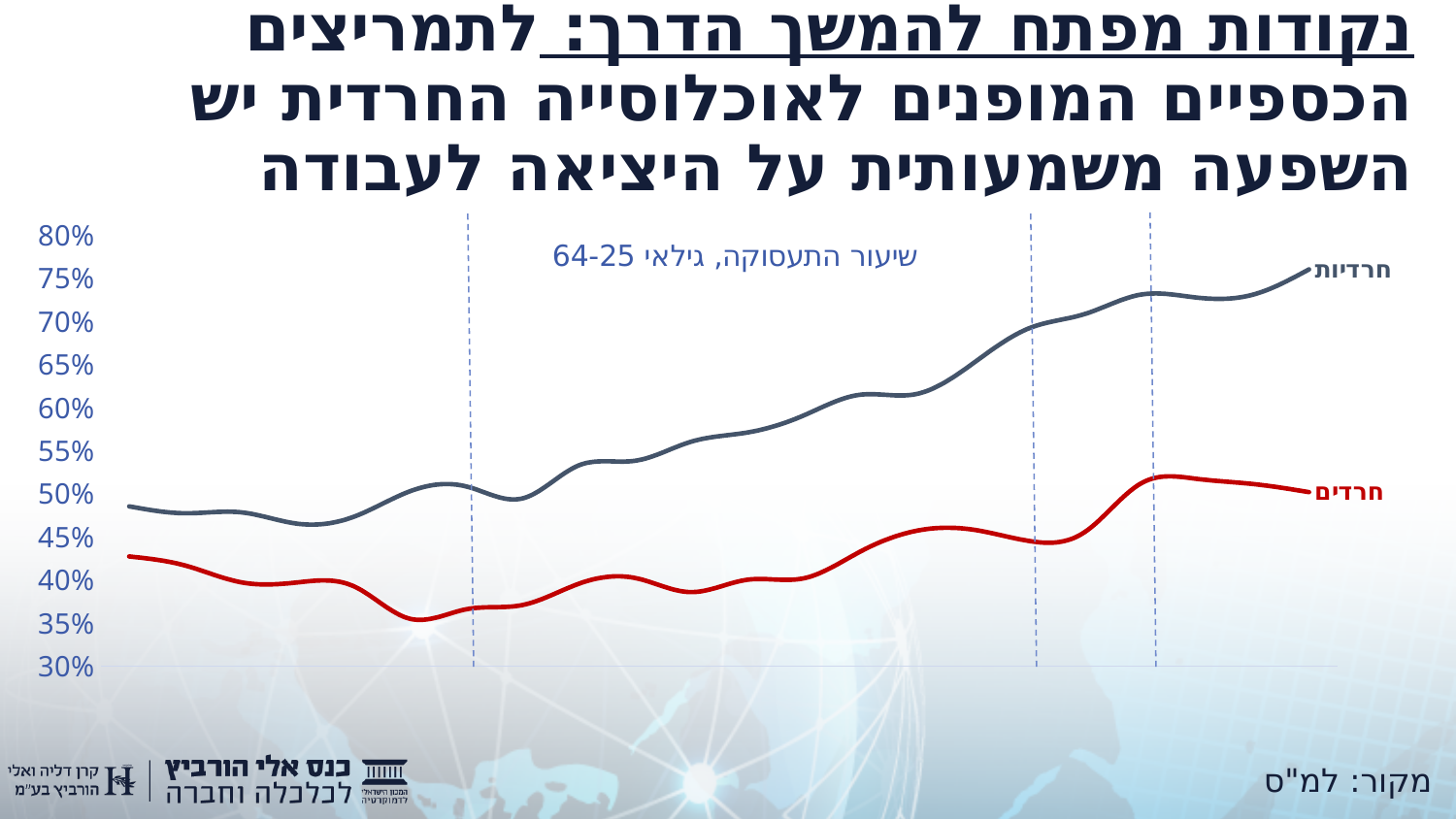
Is the value for חרדים at the left end of the chart greater or less than 40%? greater How many series does the chart show? 2 What kind of chart is shown on the slide? line chart What is the title of the chart? שיעור התעסוקה, גילאי 64-25 Is the value for חרדיות at the right end of the chart greater or less than 70%? greater Is the lowest value for חרדים greater or less than 40%? less What colour is the line for חרדים? red Which series has the higher employment rate at the right end of the chart, חרדיות or חרדים? חרדיות Which series has the higher employment rate at the left end of the chart, חרדיות or חרדים? חרדיות Does the employment rate for חרדים rise or fall overall along the x axis? rise Does the employment rate for חרדיות rise or fall overall along the x axis? rise